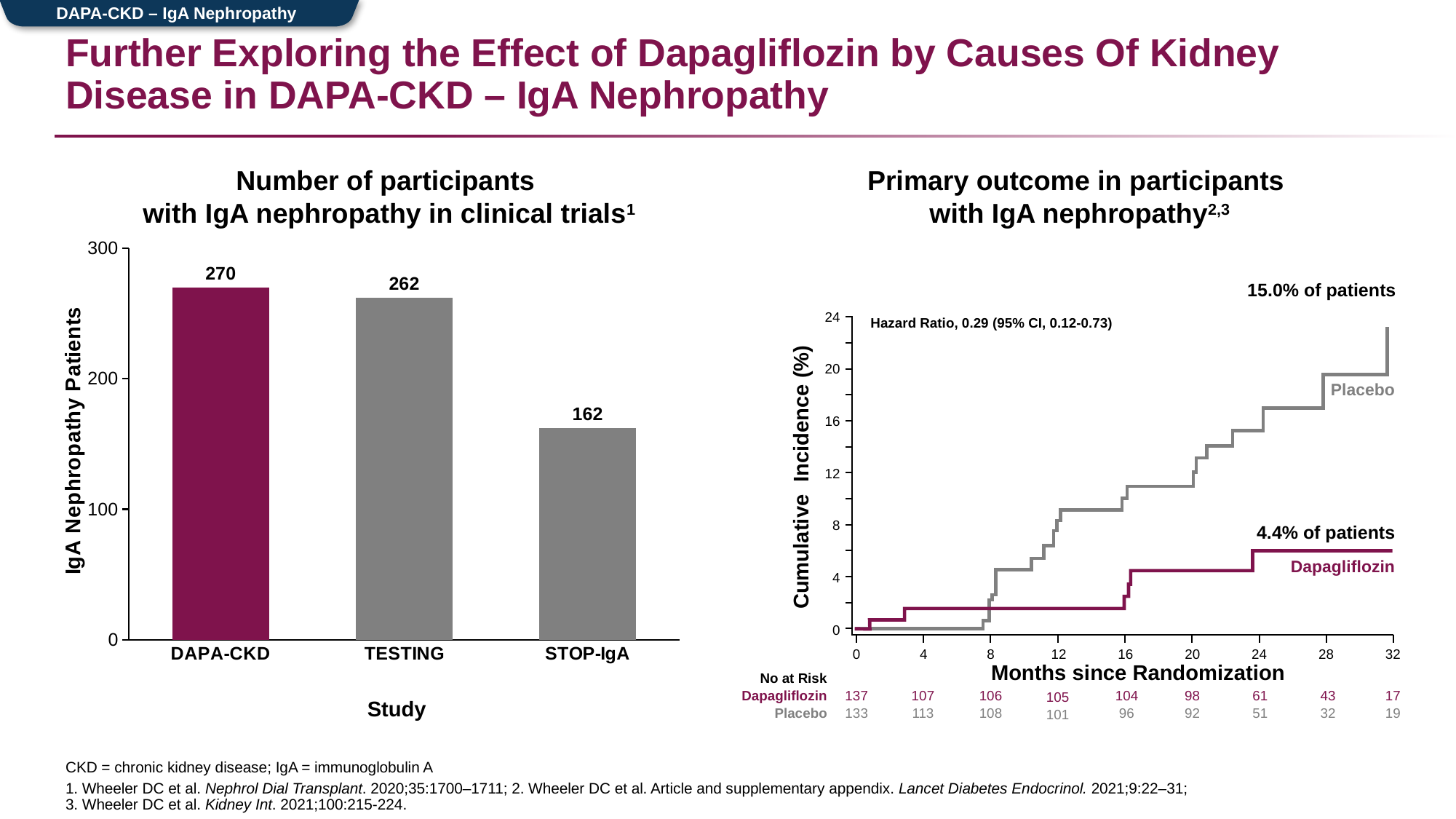
In the 'Primary outcome in participants with IgA nephropathy' chart, which group has the higher cumulative incidence at 32 months, Placebo or Dapagliflozin? Placebo In the 'Number of participants with IgA nephropathy in clinical trials' chart, how many IgA nephropathy patients were in STOP-IgA? 162 In the 'Primary outcome in participants with IgA nephropathy' chart, what is the hazard ratio shown? 0.29 (95% CI, 0.12-0.73) In the 'Number of participants with IgA nephropathy in clinical trials' chart, which study has the lowest number of IgA nephropathy patients? STOP-IgA In the 'Primary outcome in participants with IgA nephropathy' chart, what percentage of patients is labelled for the Dapagliflozin curve? 4.4% of patients What kind of chart is the 'Number of participants with IgA nephropathy in clinical trials' chart? Bar chart In the 'Number of participants with IgA nephropathy in clinical trials' chart, what is the difference between the DAPA-CKD and TESTING values? 8 In the 'Primary outcome in participants with IgA nephropathy' chart, how many Dapagliflozin patients were at risk at 24 months? 61 In the 'Primary outcome in participants with IgA nephropathy' chart, what percentage of patients is labelled for the Placebo curve? 15.0% of patients In the 'Number of participants with IgA nephropathy in clinical trials' chart, which study has the highest number of IgA nephropathy patients? DAPA-CKD In the 'Number of participants with IgA nephropathy in clinical trials' chart, how many IgA nephropathy patients were in DAPA-CKD? 270 In the 'Number of participants with IgA nephropathy in clinical trials' chart, how many studies are shown? 3